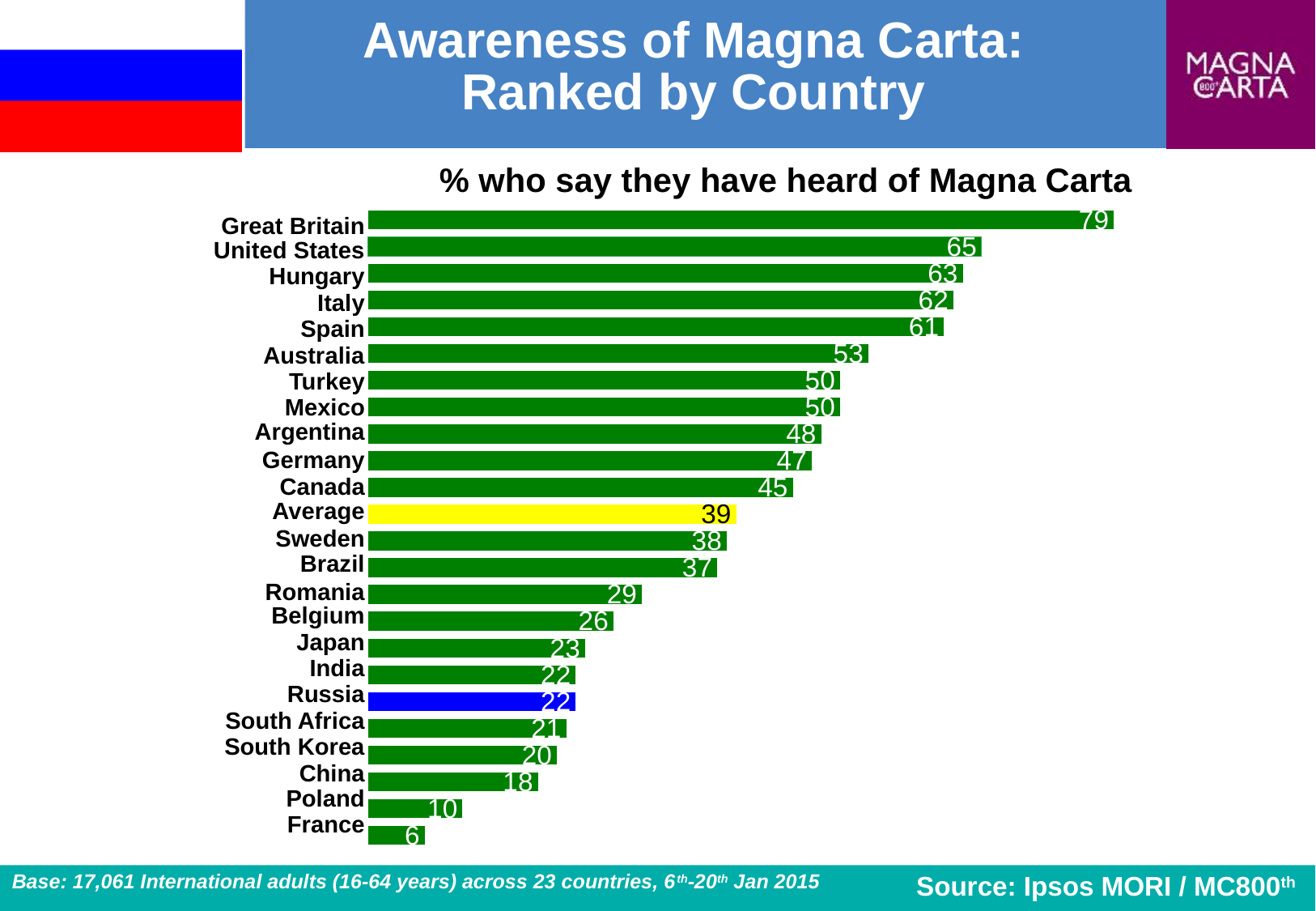
Which country has the lowest percentage who say they have heard of Magna Carta? France What is the Average value shown on the chart? 39 Which has a higher value, Poland or China? China What type of chart is shown on the slide? Bar chart What is the difference between the values for Great Britain and the United States? 14 What is the value shown for Russia? 22 What percentage of people in Great Britain say they have heard of Magna Carta? 79 How many bars are plotted on the chart, including the Average bar? 24 What is the difference between the value for Russia and the Average? 17 Which country has the highest percentage who say they have heard of Magna Carta? Great Britain Which bar on the chart is coloured yellow? Average Which has a higher value, Canada or Sweden? Canada